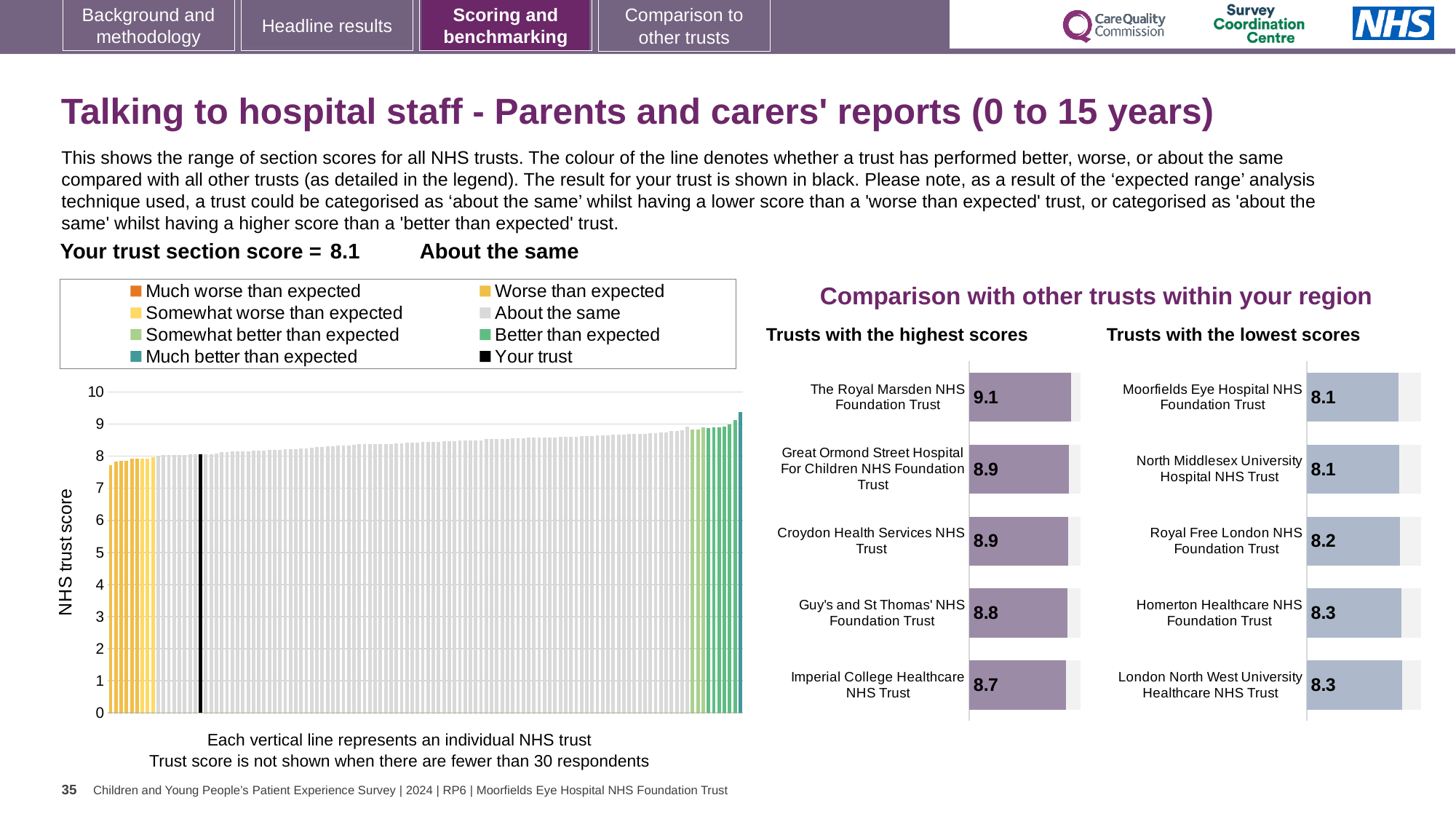
What is the y-axis label of the large chart on the left? NHS trust score In the 'Trusts with the highest scores' chart, what is the score for The Royal Marsden NHS Foundation Trust? 9.1 In the 'Trusts with the lowest scores' chart, what is the difference between the scores of Homerton Healthcare NHS Foundation Trust and Moorfields Eye Hospital NHS Foundation Trust? 0.2 In the 'Trusts with the lowest scores' chart, what is the score for Royal Free London NHS Foundation Trust? 8.2 In the 'Trusts with the highest scores' chart, which trust has the lowest score shown? Imperial College Healthcare NHS Trust In the 'Trusts with the highest scores' chart, what is the difference between the scores of The Royal Marsden NHS Foundation Trust and Imperial College Healthcare NHS Trust? 0.4 In the large chart on the left, do the trust scores rise or fall from left to right? Rise What kind of chart is the large chart on the left showing the range of NHS trust scores? Bar chart In the large chart on the left, is the value of the black 'Your trust' bar greater or less than 5? greater In the 'Trusts with the lowest scores' chart, what is the score for London North West University Healthcare NHS Trust? 8.3 In the 'Trusts with the highest scores' chart, how many trusts are listed? 5 In the 'Trusts with the lowest scores' chart, which is larger: the score for Royal Free London NHS Foundation Trust or Homerton Healthcare NHS Foundation Trust? Homerton Healthcare NHS Foundation Trust